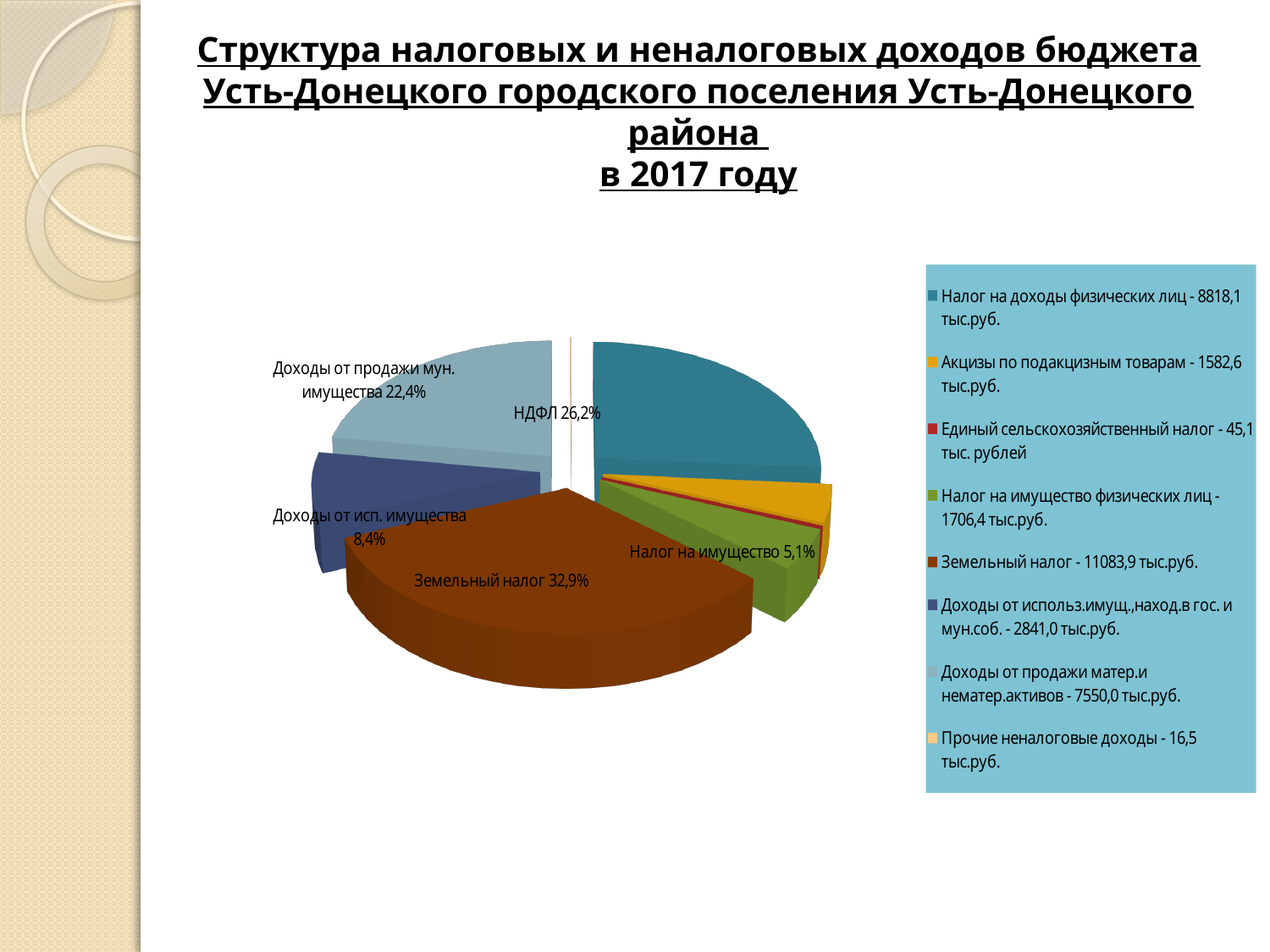
How many entries does the legend list? 8 What share of the pie does the slice labelled Налог на имущество represent? 5,1% What is the difference in percentage points between the Земельный налог slice and the НДФЛ slice? 6,7 According to the legend, what is the value for Налог на доходы физических лиц? 8818,1 тыс.руб. What share of the pie does the slice labelled Доходы от продажи мун. имущества represent? 22,4% What share of the pie does the slice labelled Земельный налог represent? 32,9% What kind of chart is shown on the slide? Pie chart Which slice is larger: НДФЛ or Доходы от продажи мун. имущества? НДФЛ Which slice of the pie has the largest share? Земельный налог Which legend entry has the smallest value? Прочие неналоговые доходы - 16,5 тыс.руб. According to the legend, what is the value for Акцизы по подакцизным товарам? 1582,6 тыс.руб.